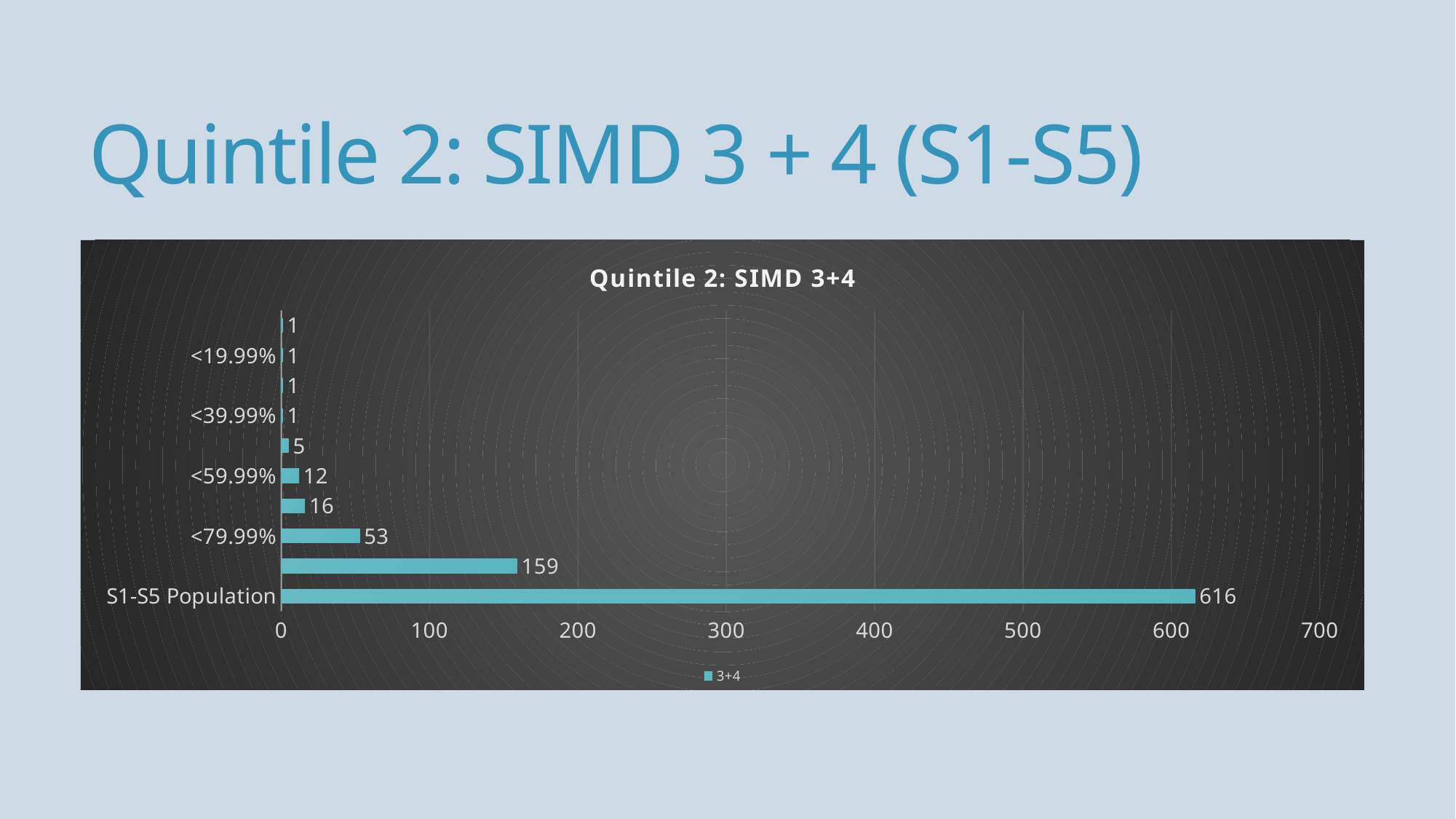
Which category has the highest value? S1-S5 Population What is the value for S1-S5 Population? 616 What is the value for the <79.99% category? 53 What is the difference between the S1-S5 Population value and the <79.99% value? 563 What is the value for the <19.99% category? 1 Which is larger, the value for <79.99% or the value for <59.99%? <79.99% How many series does the legend list? 1 Is the value for S1-S5 Population greater or less than 600? greater What is the value for the <59.99% category? 12 What is the difference between the <79.99% value and the <59.99% value? 41 How many bars are plotted in the chart? 10 What type of chart is shown on the slide? bar chart